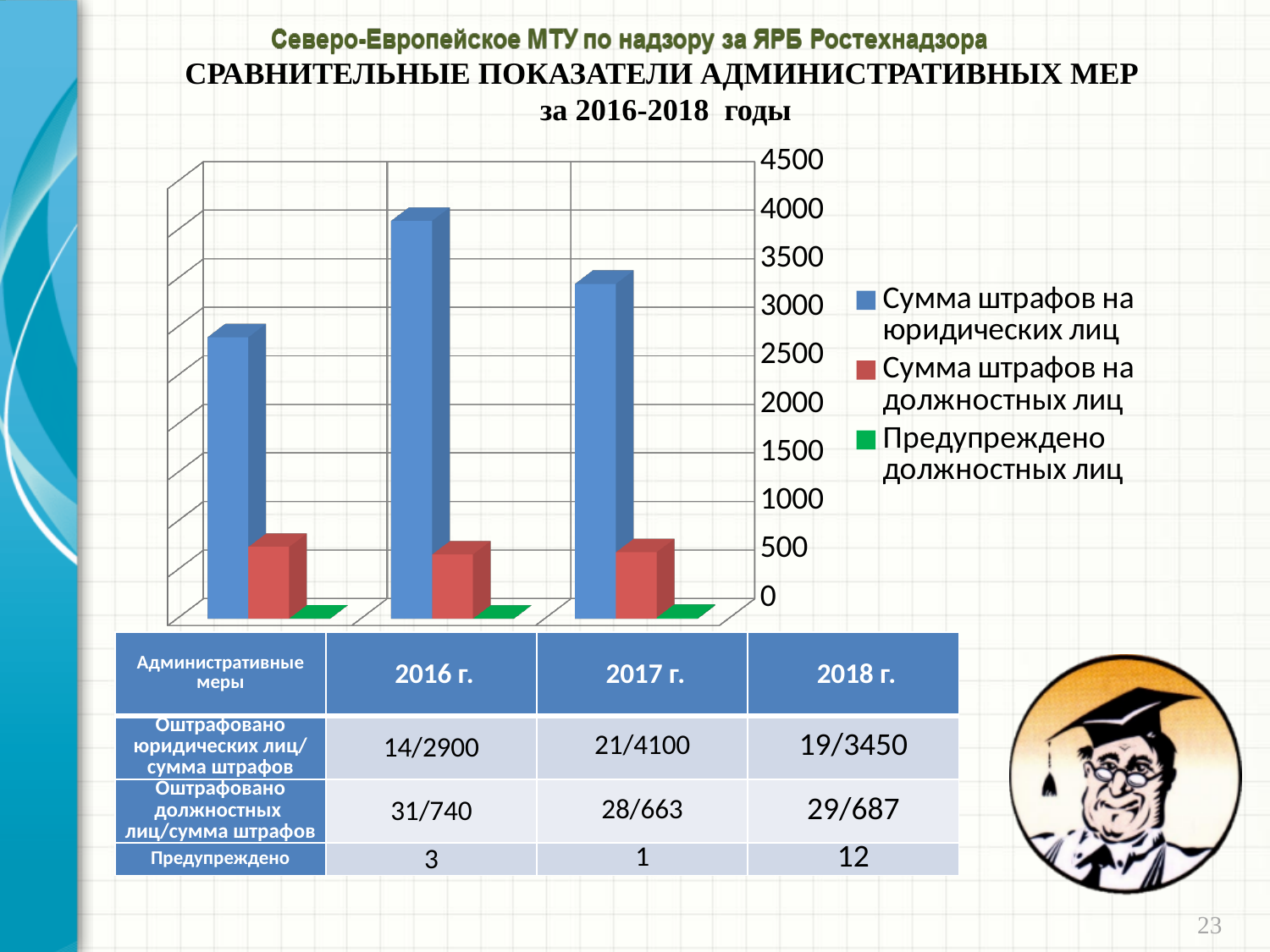
How many series does the chart legend list? 3 How many groups of bars are plotted in the chart? 3 Which group of bars (left, middle or right) has the shortest bar for 'Сумма штрафов на юридических лиц'? left Does the 'Сумма штрафов на юридических лиц' bar rise or fall from the left group to the middle group? rise What colour represents 'Предупреждено должностных лиц' in the chart legend? green Is the value of the 'Сумма штрафов на юридических лиц' bar in the left group greater or less than 2500? greater What kind of chart is shown on the slide? bar chart Is the value of the 'Сумма штрафов на должностных лиц' bar in the left group greater or less than 1000? less Which group of bars (left, middle or right) has the tallest bar for 'Сумма штрафов на юридических лиц'? middle In the left group, which is larger: the 'Сумма штрафов на юридических лиц' bar or the 'Сумма штрафов на должностных лиц' bar? Сумма штрафов на юридических лиц